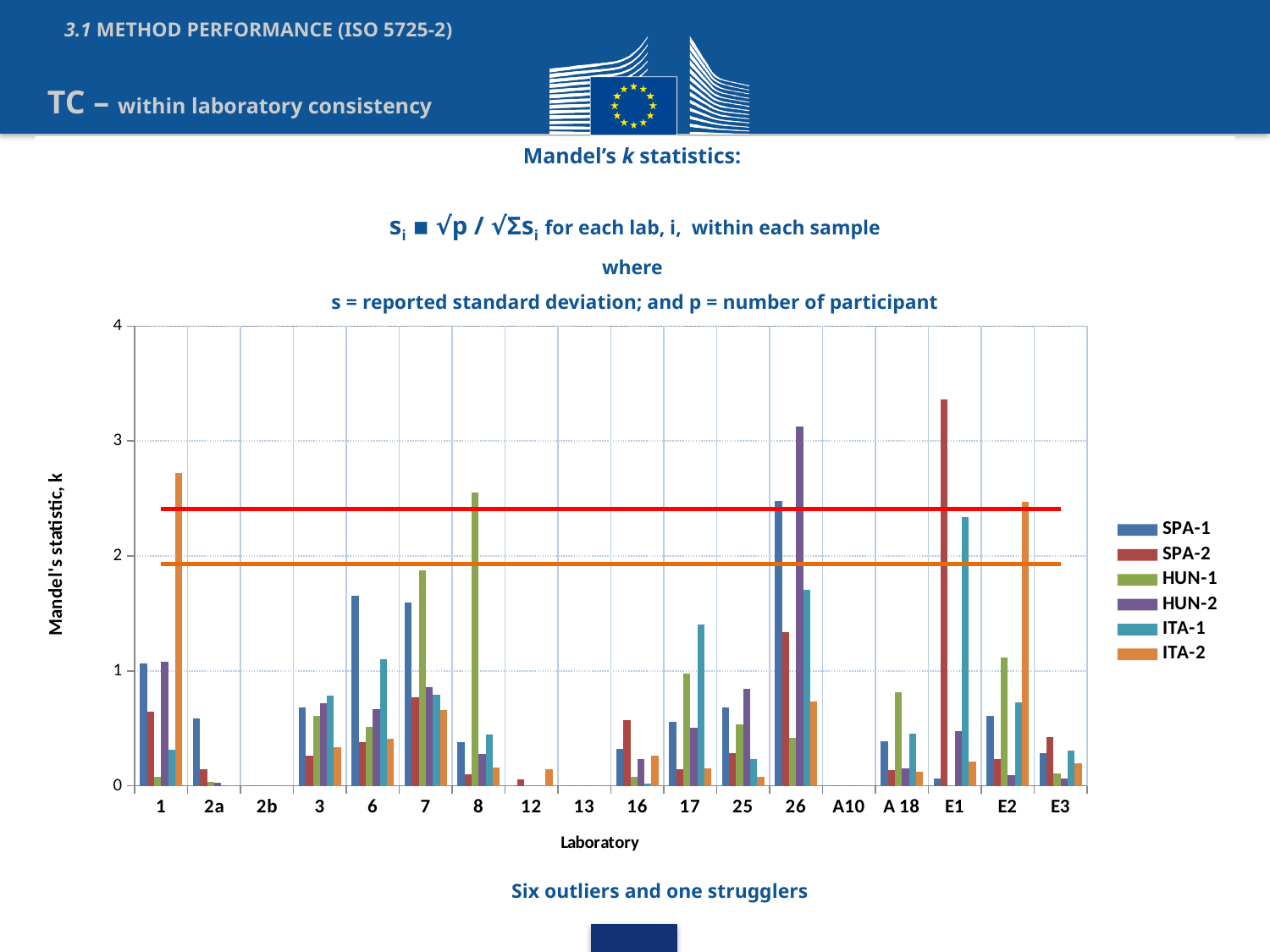
At laboratory 26, which is larger: the HUN-2 value or the SPA-1 value? HUN-2 At laboratory 1, which is larger: the ITA-2 value or the SPA-1 value? ITA-2 Is the HUN-1 value for laboratory 8 greater or less than 2? greater Which series has the tallest bar at laboratory E1? SPA-2 What kind of chart is shown on the slide? bar chart Is the ITA-2 value for laboratory 1 greater or less than 2? greater How many laboratory categories are shown on the x axis? 18 What is the title of the x axis? Laboratory Which laboratory has the tallest bar in the chart? E1 Is the SPA-2 value for laboratory E1 greater or less than 3? greater How many series does the legend list? 6